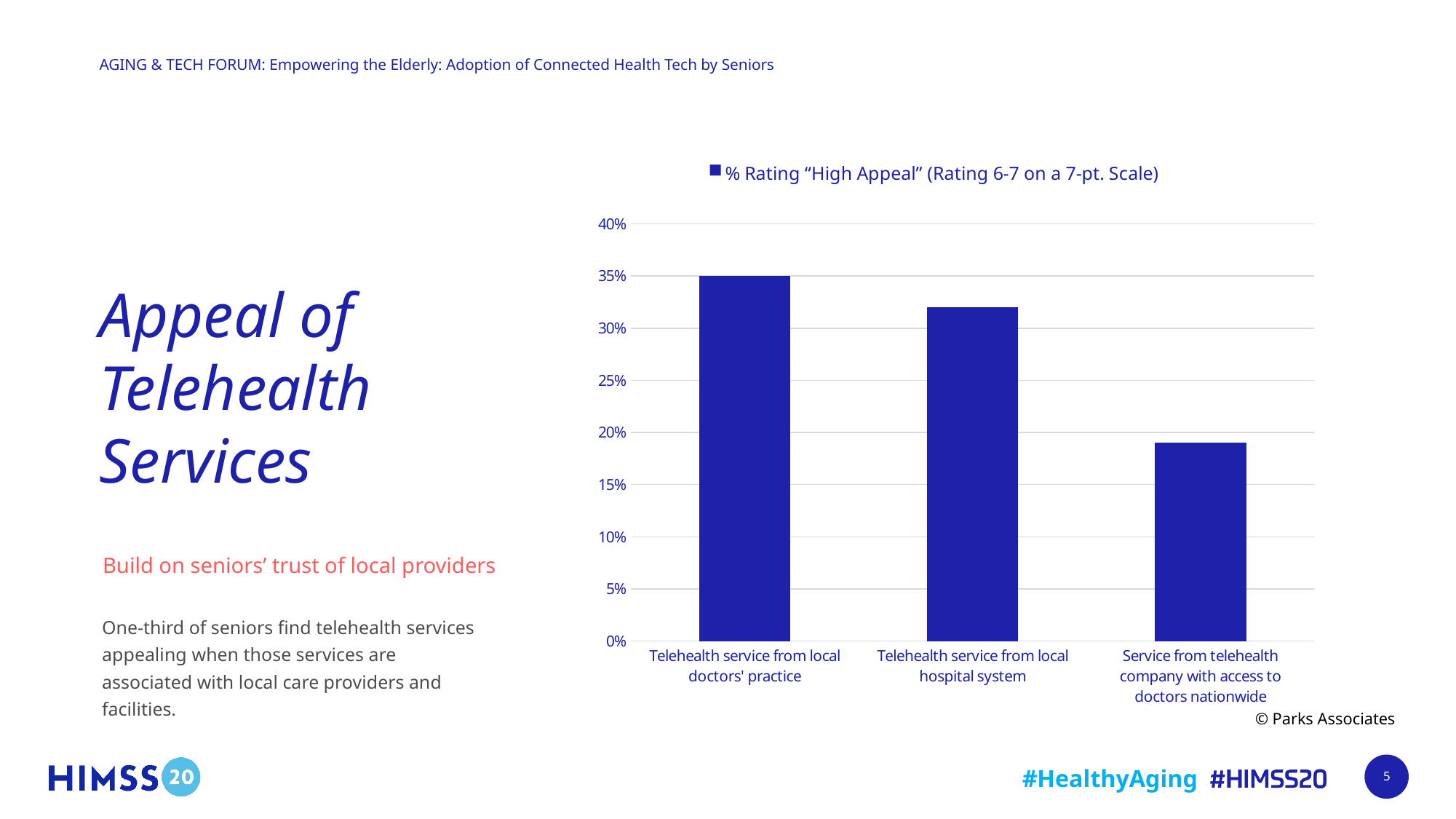
How many categories are plotted in the chart? 3 How many series does the chart legend list? 1 Is the value for 'Telehealth service from local doctors' practice' greater or less than 30%? greater What kind of chart is shown on the slide? bar chart Is the value for 'Telehealth service from local hospital system' greater or less than 30%? greater What is the series name shown in the chart legend? % Rating "High Appeal" (Rating 6-7 on a 7-pt. Scale) Do the bar values rise or fall from left to right across the chart? fall Which category has the highest value in the chart? Telehealth service from local doctors' practice Which is larger: the value for 'Telehealth service from local hospital system' or the value for 'Service from telehealth company with access to doctors nationwide'? Telehealth service from local hospital system Is the value for 'Service from telehealth company with access to doctors nationwide' greater or less than 20%? less What is the highest value shown on the chart's vertical axis? 40% Which category has the lowest value in the chart? Service from telehealth company with access to doctors nationwide